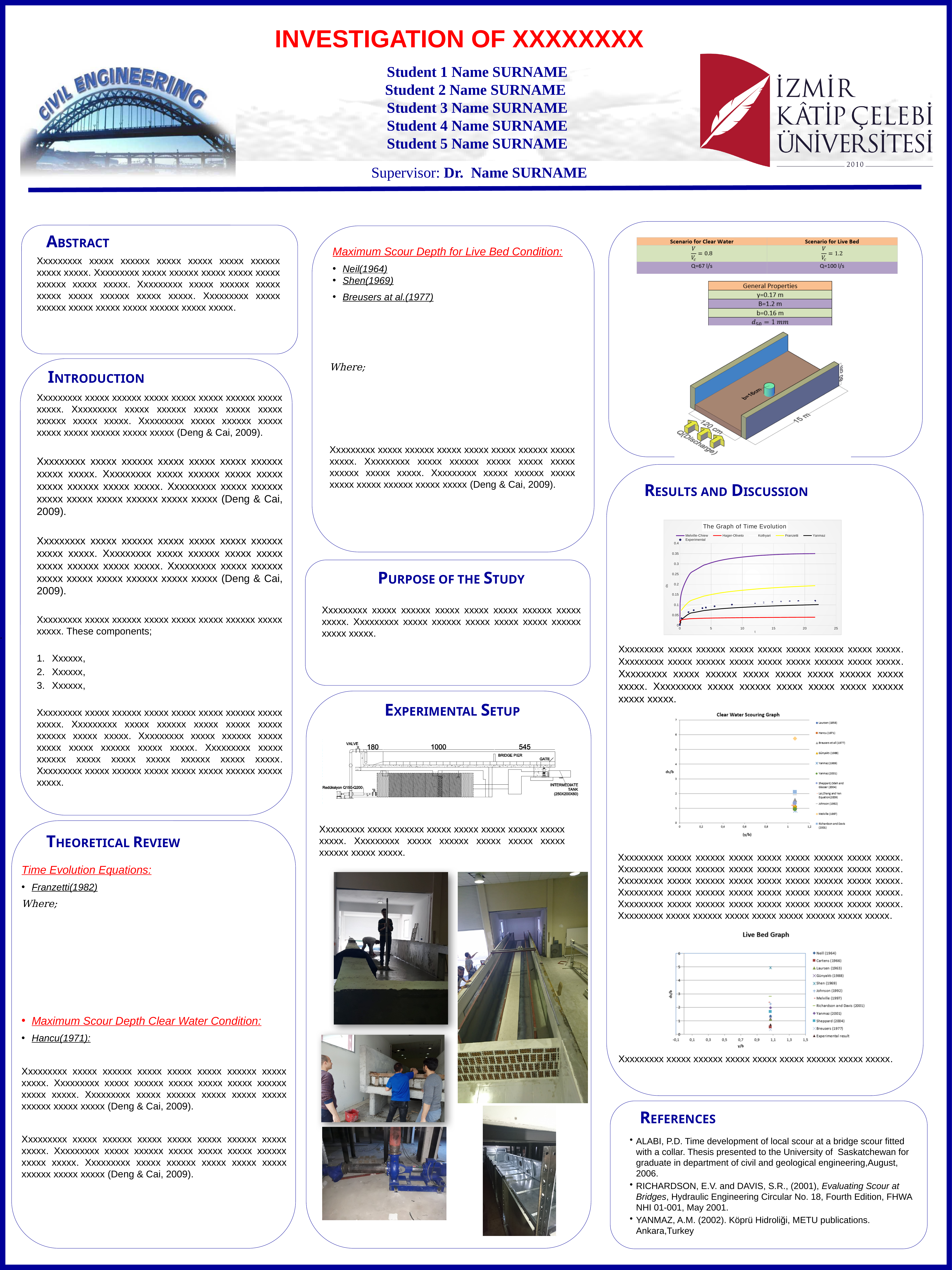
In 'The Graph of Time Evolution', which series reaches the highest values? Melville-Chiew In 'The Graph of Time Evolution', which is larger at t=20, the Franzetti value or the Yanmaz value? Franzetti How many series does the legend of 'The Graph of Time Evolution' list? 6 In the 'Clear Water Scouring Graph', is the highest plotted point greater or less than 5 on the ds/b axis? greater What kind of chart is 'The Graph of Time Evolution'? line chart In 'The Graph of Time Evolution', does the Melville-Chiew curve rise or fall as t increases? rises How many series does the legend of the 'Live Bed Graph' list? 12 In 'The Graph of Time Evolution', is the Hager-Oliveto value at t=20 greater or less than 0.1? less In the 'Live Bed Graph', is the highest plotted point greater or less than 4 on the ds/b axis? greater In 'The Graph of Time Evolution', which series has the lowest values? Hager-Oliveto What kind of chart is the 'Clear Water Scouring Graph'? scatter chart